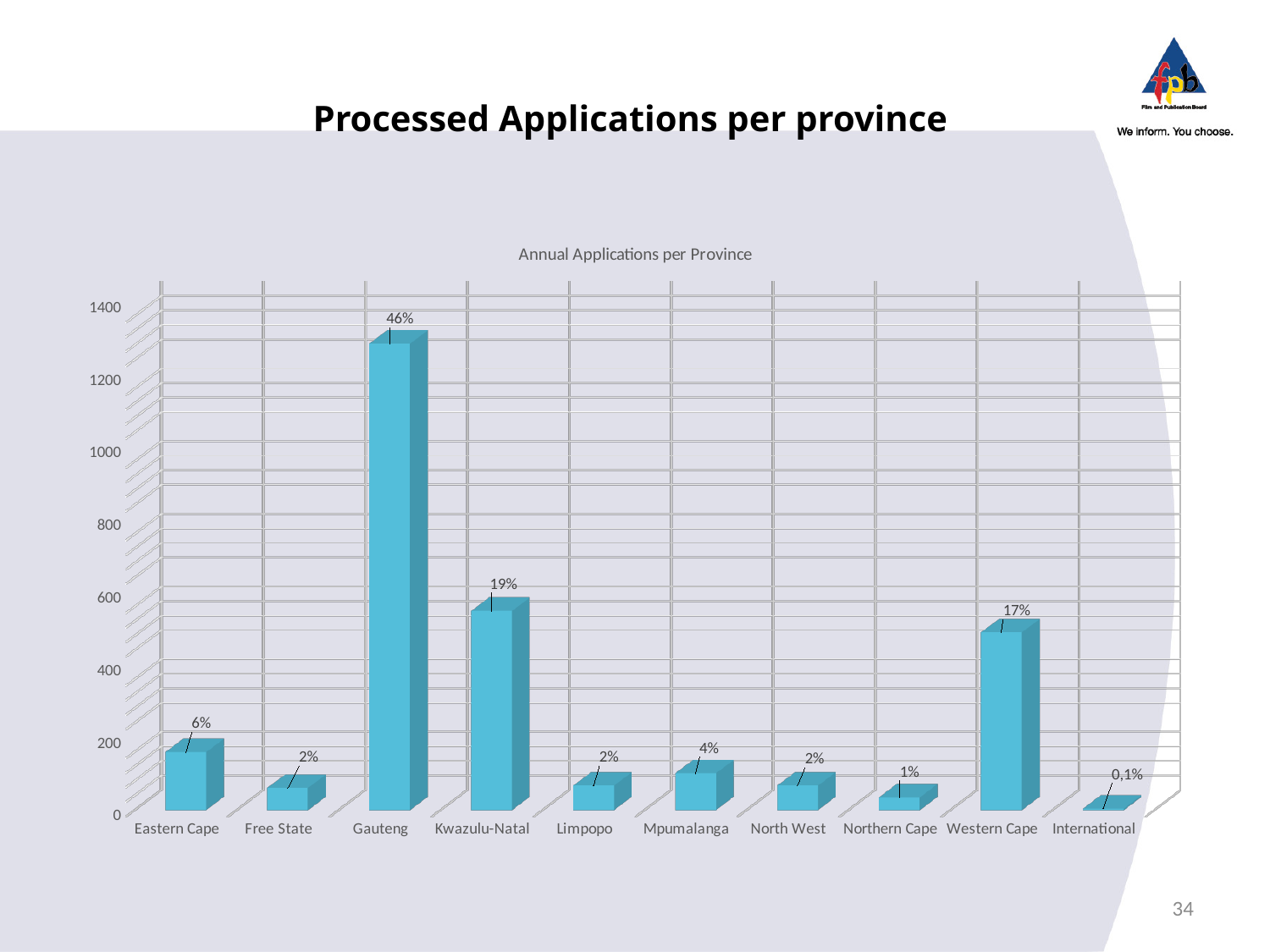
What kind of chart is shown on the slide? bar chart Which has the larger share, Kwazulu-Natal or Western Cape? Kwazulu-Natal How many provinces/categories are shown on the x axis of the chart? 10 Is the value for Gauteng greater or less than 1200? greater Which category has the lowest value in the chart? International What percentage label is shown for International? 0,1% What percentage label is shown for Kwazulu-Natal? 19% What is the difference in percentage points between the labels for Gauteng and Kwazulu-Natal? 27% What is the title shown above the chart's plot area? Annual Applications per Province What percentage label is shown for Western Cape? 17% What percentage label is shown for Gauteng? 46% Which category has the highest value in the chart? Gauteng